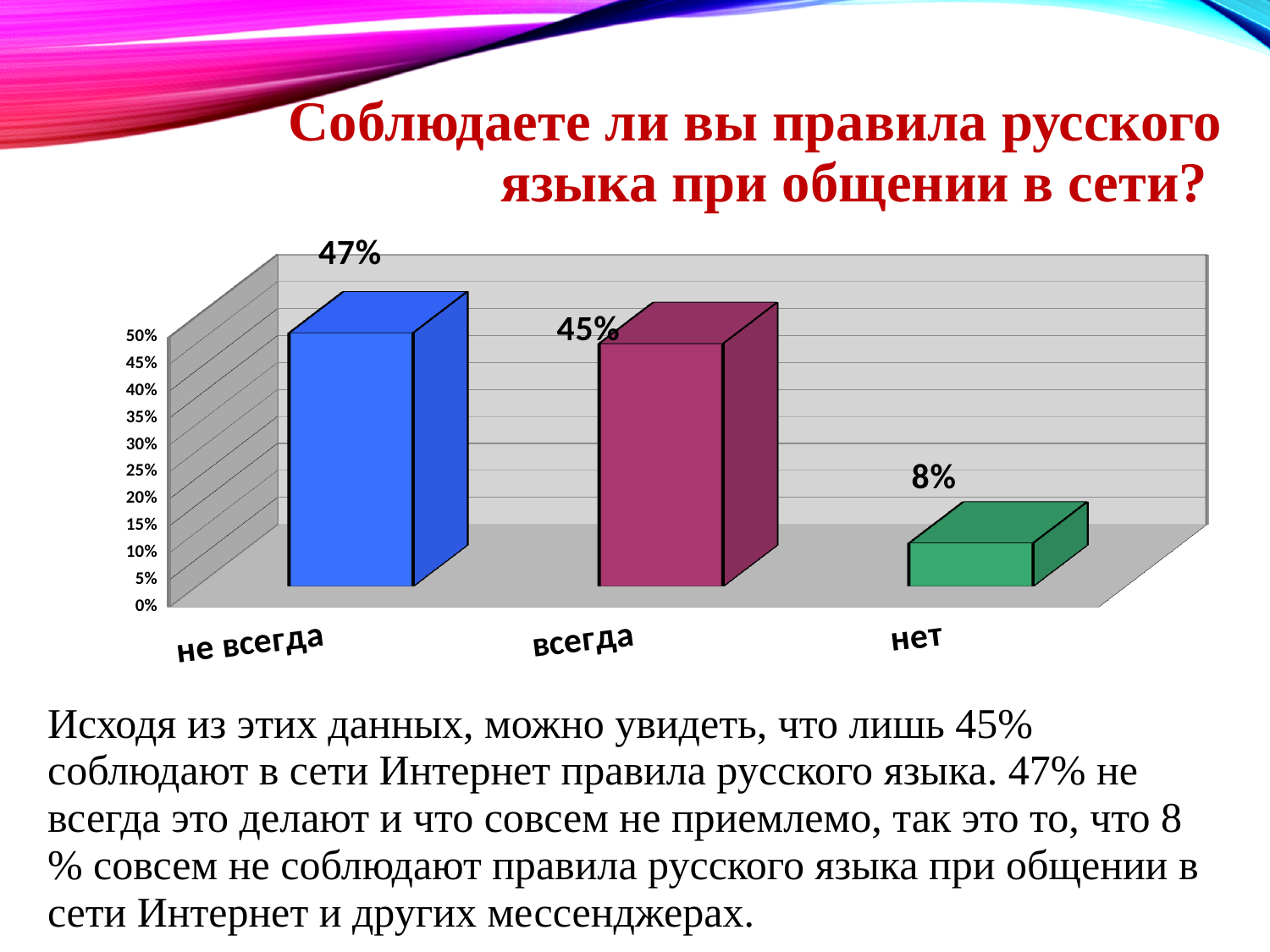
Is the value for "нет" greater or less than 10%? less What is the difference between the values for "не всегда" and "всегда"? 2% How many categories are shown on the x axis? 3 Which category has the highest value? не всегда Which is larger, the value for "всегда" or the value for "нет"? всегда What kind of chart is shown on the slide? bar chart What is the difference between the values for "всегда" and "нет"? 37% What is the value for "не всегда"? 47% What colour is the bar for "нет"? green What is the value for "нет"? 8% Which category has the lowest value? нет What is the value for "всегда"? 45%